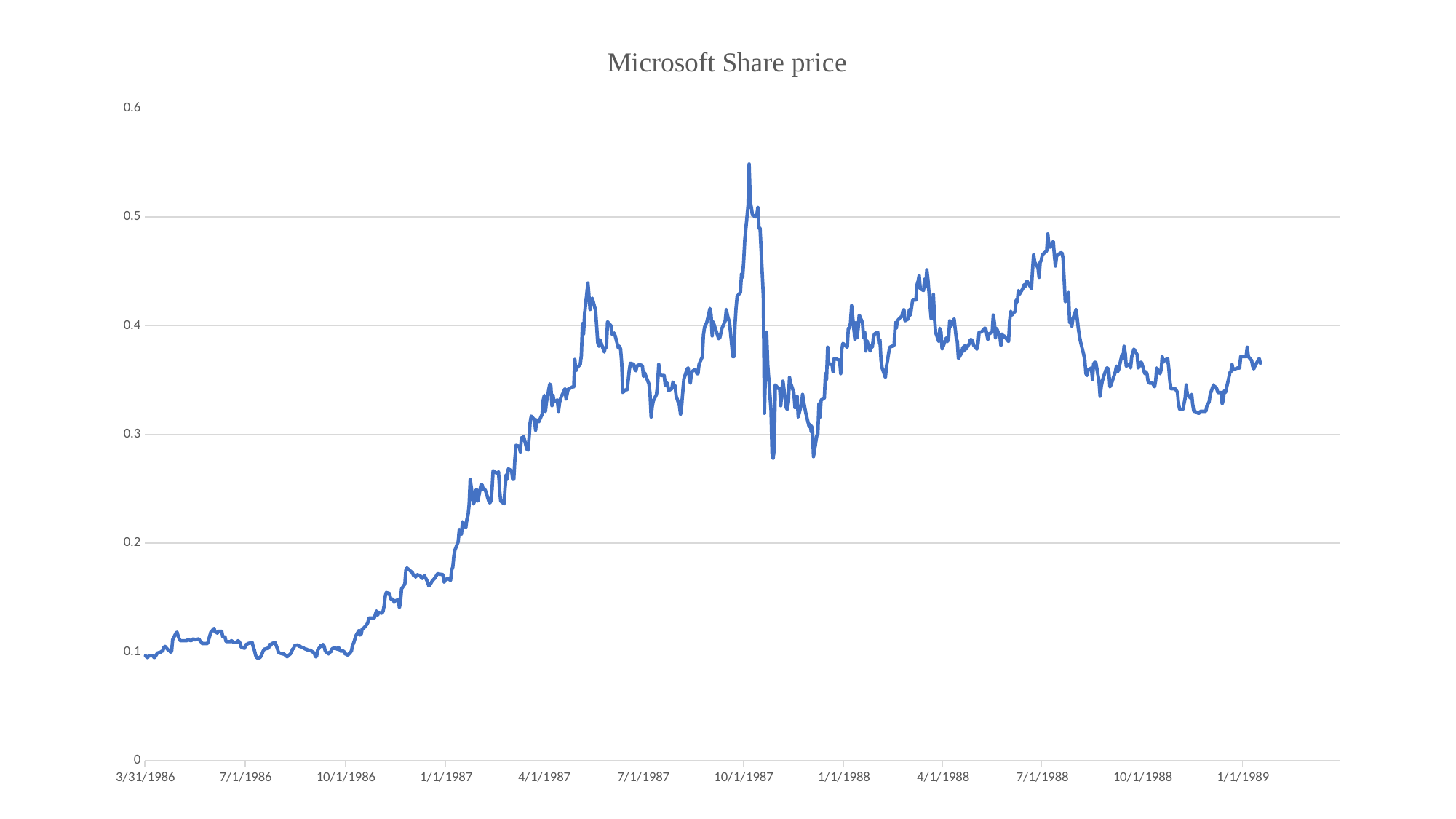
What is the highest value shown on the y axis? 0.6 Is the value at 1/1/1989 greater or less than 0.3? greater Near which x-axis date does the line reach its highest point? 10/1/1987 Is the value at 1/1/1987 greater or less than 0.2? less Is the value at 10/1/1986 greater or less than 0.2? less Overall, does the share price rise or fall from 3/31/1986 to 1/1/1989? rise What is the title of the chart? Microsoft Share price What kind of chart is shown on the slide? line chart How many lines (series) are plotted on the chart? 1